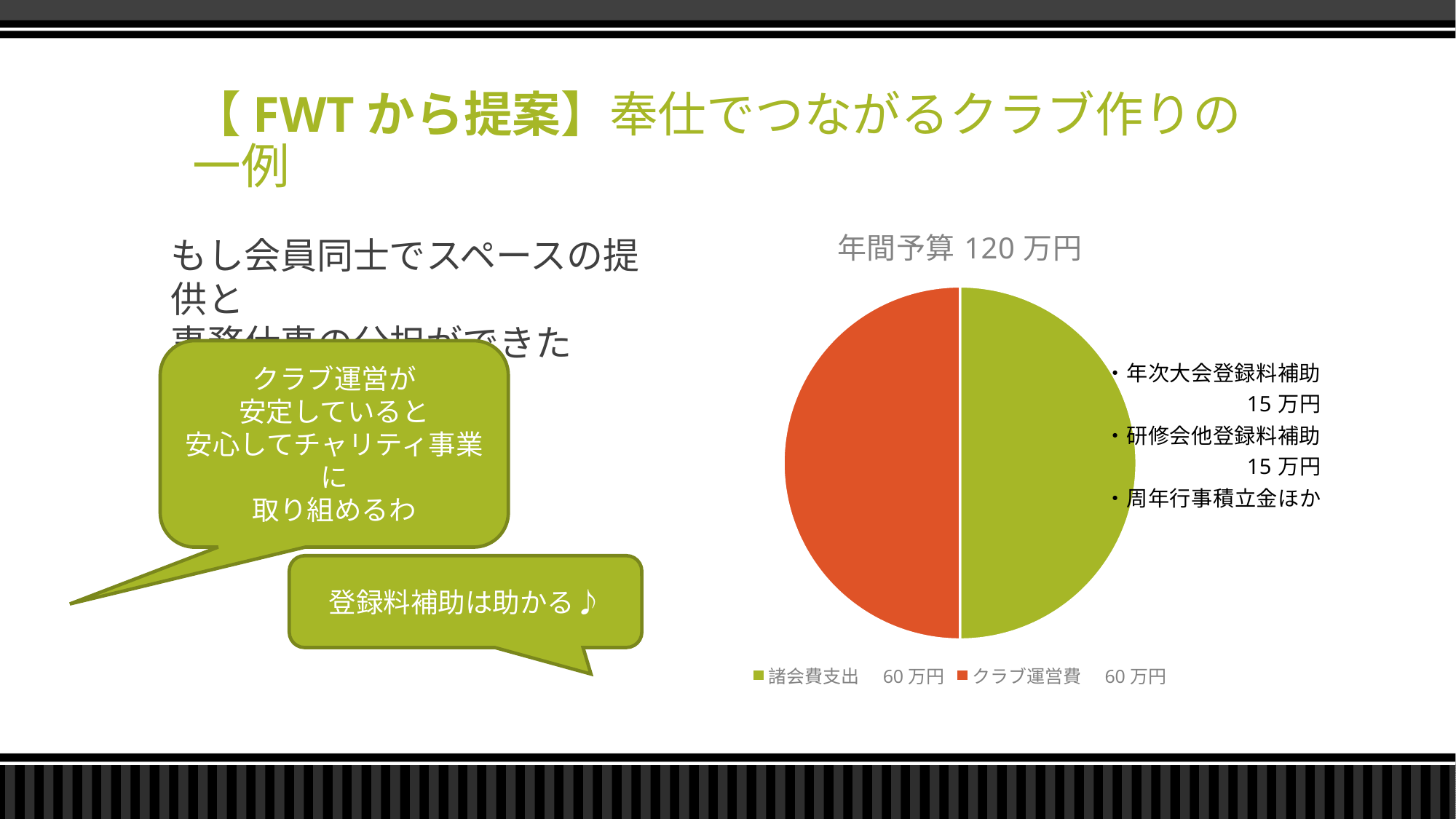
How many entries does the legend of the pie chart list? 2 What value is shown in the legend for クラブ運営費? 60 万円 What value is shown in the legend for 諸会費支出? 60 万円 What kind of chart is shown on the slide? pie chart What is the title of the pie chart? 年間予算 120 万円 What share of the pie does クラブ運営費 represent? 50% What is the total of the two slices in the pie chart? 120 万円 Which colour represents クラブ運営費 in the pie chart? orange What is the difference between the values for 諸会費支出 and クラブ運営費? 0 万円 How many slices does the pie chart have? 2 What share of the pie does 諸会費支出 represent? 50%